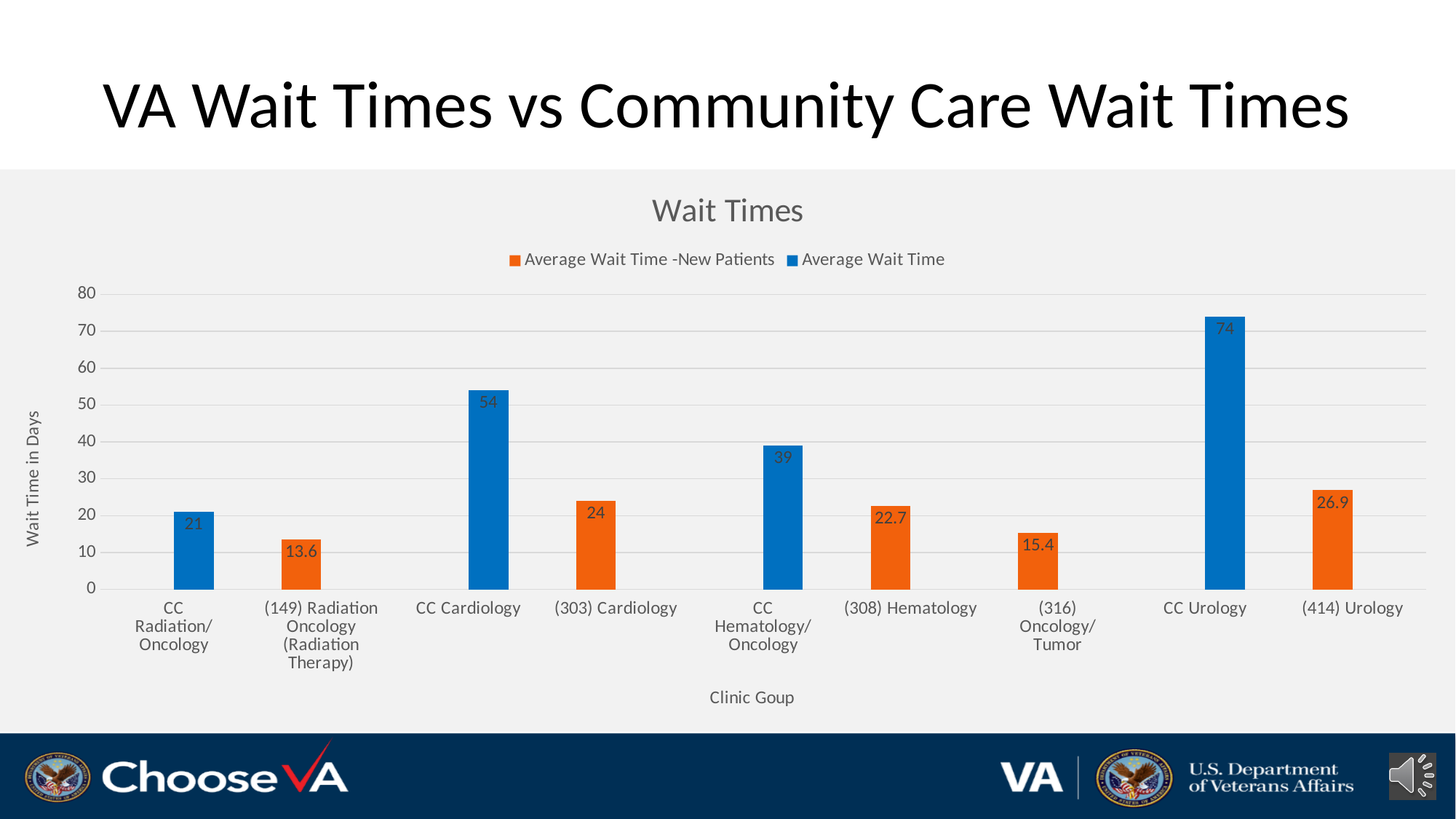
What is the title of the chart? Wait Times What is the value for CC Urology? 74 Which is larger, the value for CC Hematology/Oncology or the value for (308) Hematology? CC Hematology/Oncology What kind of chart is shown? bar chart How many categories are shown on the x axis? 9 Which category has the highest value? CC Urology What is the value for (308) Hematology? 22.7 Which category has the lowest value? (149) Radiation Oncology (Radiation Therapy) Is the value for (414) Urology greater or less than 30? less How many series does the legend list? 2 What is the value for (149) Radiation Oncology (Radiation Therapy)? 13.6 What is the difference between the values for CC Cardiology and (303) Cardiology? 30